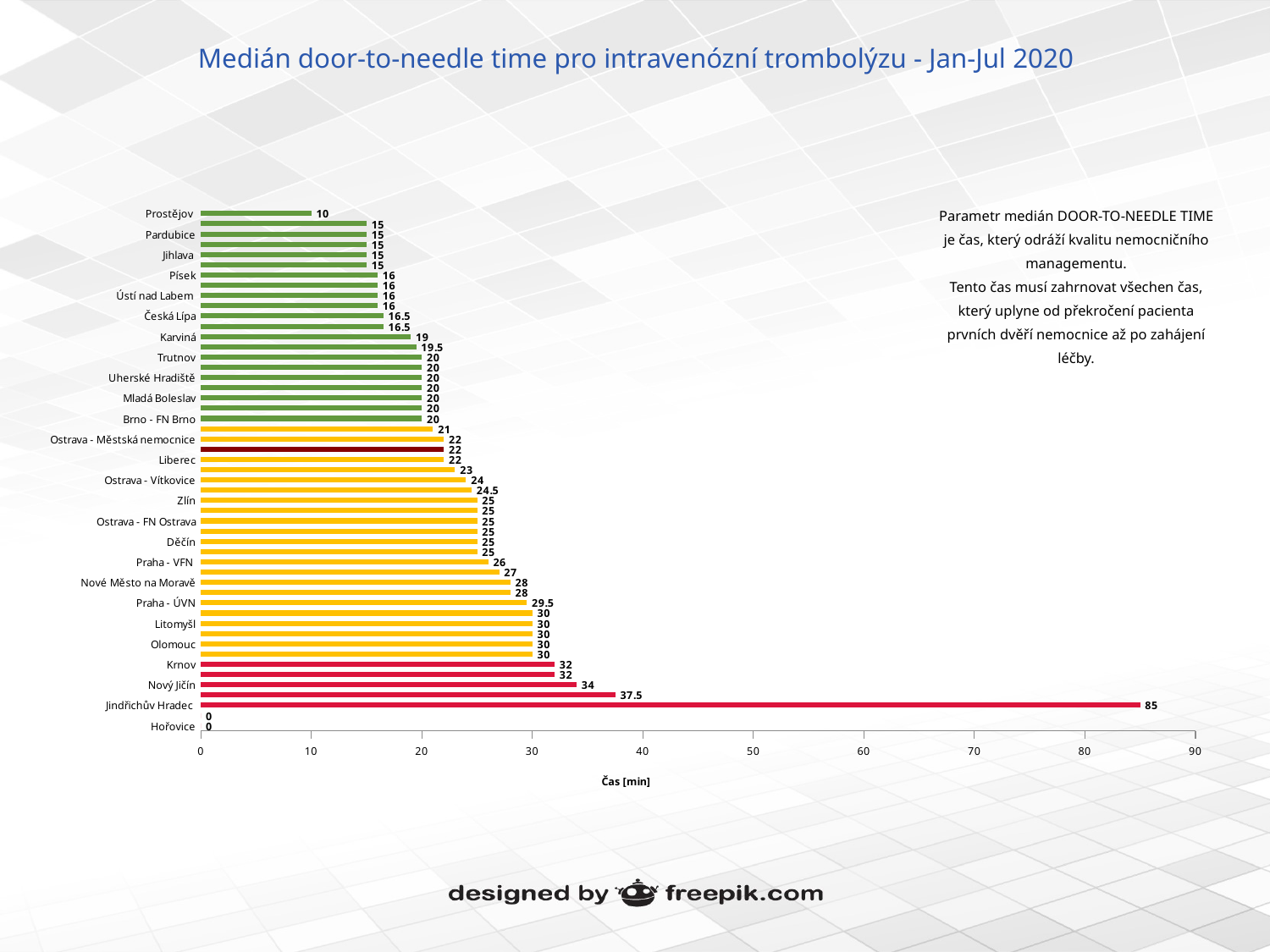
What is the title of the horizontal axis? Čas [min] Is the value for Jindřichův Hradec greater or less than 80? greater What is the difference between the values for Krnov and Liberec? 10 Which hospital has the highest median door-to-needle time? Jindřichův Hradec What is the median door-to-needle time for Prostějov? 10 What value is shown for Hořovice? 0 What is the median door-to-needle time for Jindřichův Hradec? 85 Which has a larger value, Olomouc or Karviná? Olomouc What is the difference between the values for Jindřichův Hradec and Nový Jičín? 51 What kind of chart is shown on the slide? Bar chart What value is shown for Česká Lípa? 16.5 What value is shown for Praha - ÚVN? 29.5